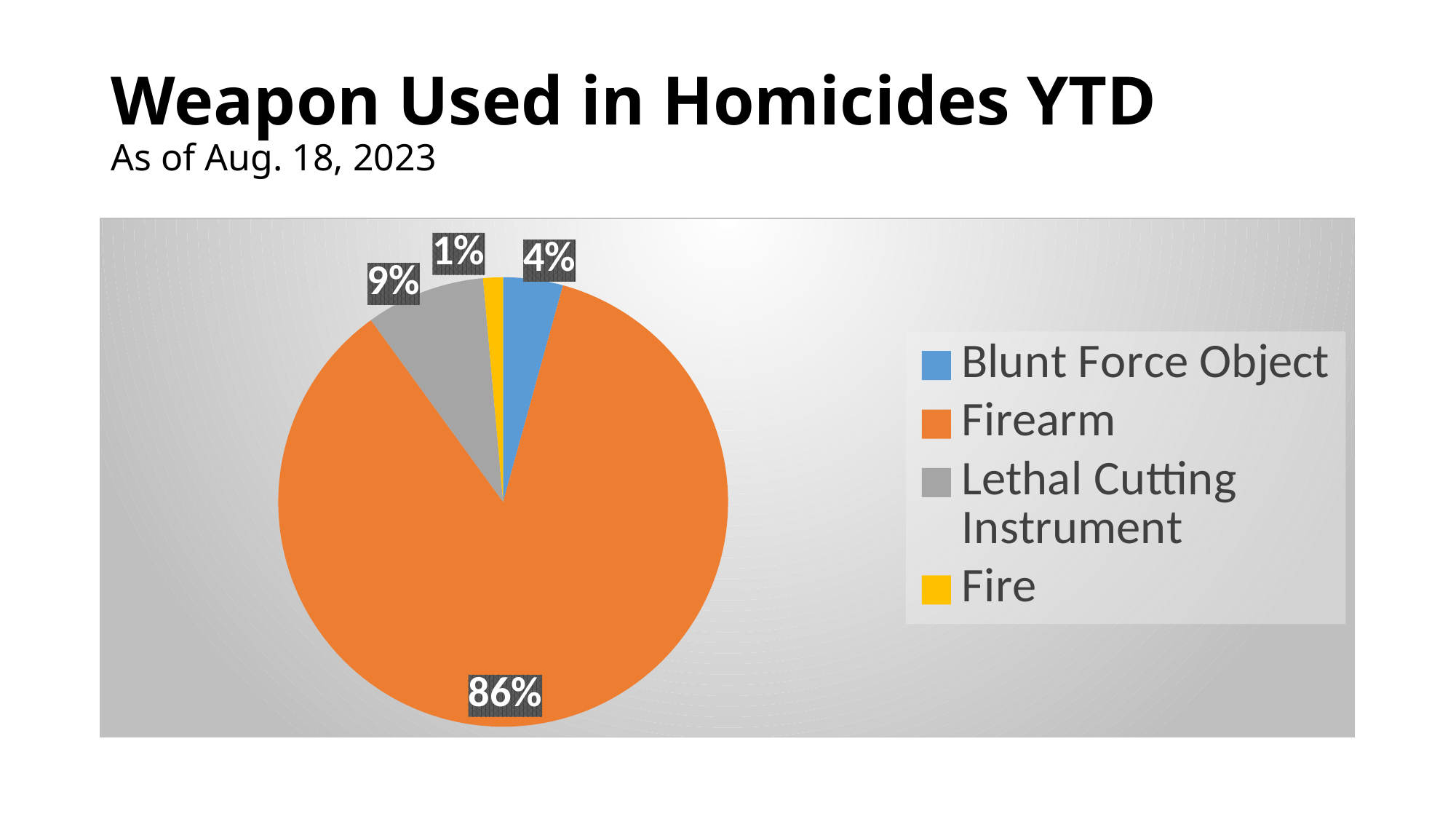
How many weapon categories does the legend list? 4 Which is larger, the Lethal Cutting Instrument slice or the Blunt Force Object slice? Lethal Cutting Instrument What share of homicides YTD involved a firearm? 86% What is the title of the slide containing the chart? Weapon Used in Homicides YTD What share of homicides YTD involved a lethal cutting instrument? 9% What kind of chart is shown on the slide? pie chart Which weapon category has the smallest slice of the pie? Fire What share of homicides YTD involved fire? 1% Which weapon category has the largest slice of the pie? Firearm What colour is the Fire slice in the pie chart? yellow What is the difference in percentage points between the Firearm and Lethal Cutting Instrument slices? 77